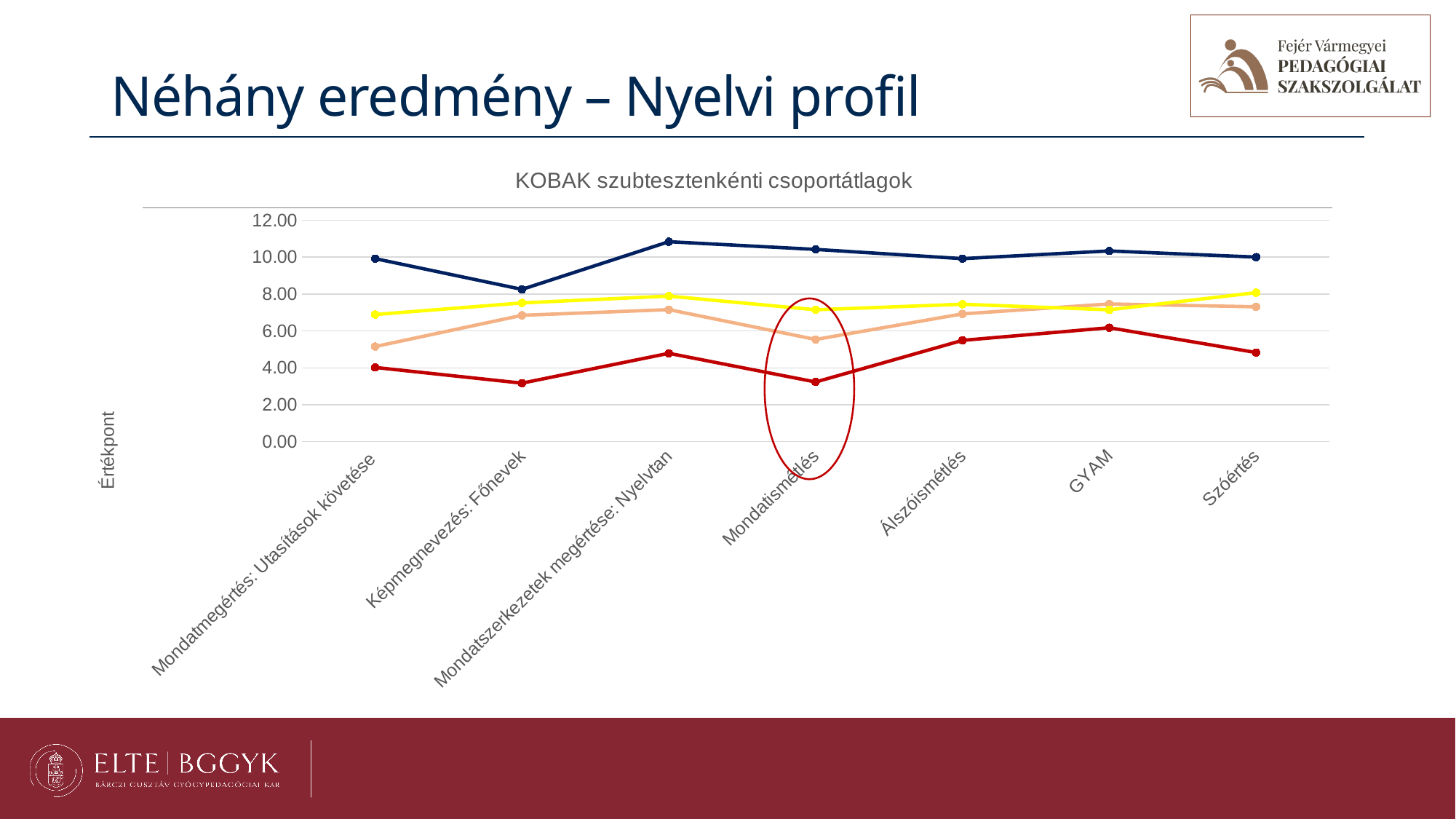
What is the label of the vertical axis? Értékpont Is the value of the red line for Mondatismétlés greater or less than 4.00? less Is the value of the yellow line for Mondatmegértés: Utasítások követése greater or less than 8.00? less At Mondatismétlés, which line has the larger value, the yellow line or the orange line? the yellow line For the red line, which category has the highest value? GYAM Does the red line rise or fall from Mondatismétlés to GYAM? rise How many categories are shown on the x axis of the chart? 7 For the dark blue line, which category has the highest value? Mondatszerkezetek megértése: Nyelvtan What is the title of the chart? KOBAK szubtesztenkénti csoportátlagok Is the value of the dark blue line for Mondatszerkezetek megértése: Nyelvtan greater or less than 10.00? greater For the dark blue line, which category has the lowest value? Képmegnevezés: Főnevek What type of chart is shown on the slide? line chart